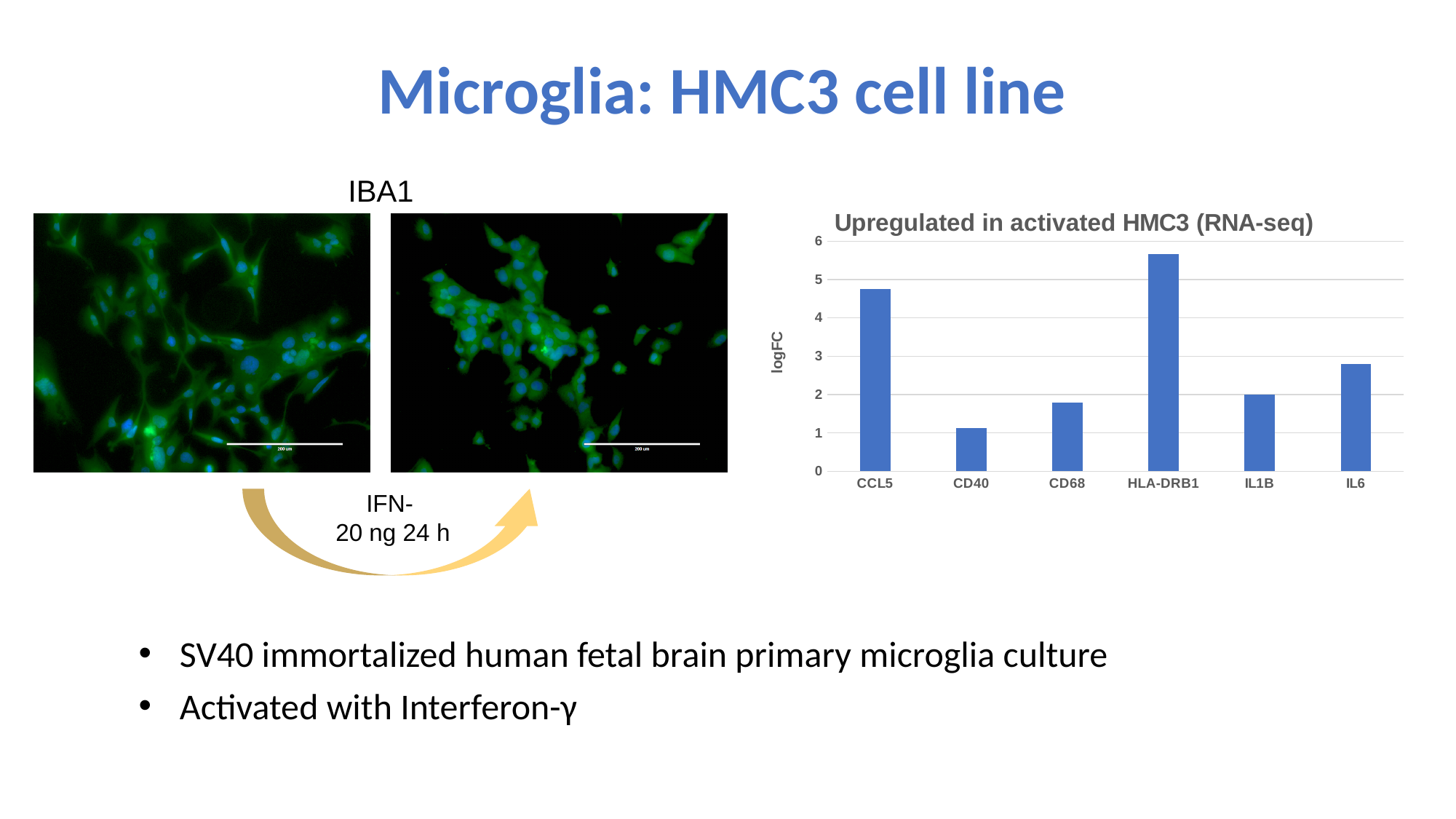
Which has a larger logFC, CD40 or IL1B? IL1B Is the logFC value for CCL5 greater or less than 4? greater Which gene has the lowest logFC in the chart? CD40 How many genes (categories) are plotted in the chart? 6 Is the logFC value for HLA-DRB1 greater or less than 5? greater What kind of chart is shown on the slide? bar chart What is the label of the y axis of the chart? logFC Which gene has the highest logFC in the chart? HLA-DRB1 Which has a larger logFC, CCL5 or IL6? CCL5 Is the logFC value for IL6 greater or less than 3? less What is the title of the chart on the slide? Upregulated in activated HMC3 (RNA-seq)